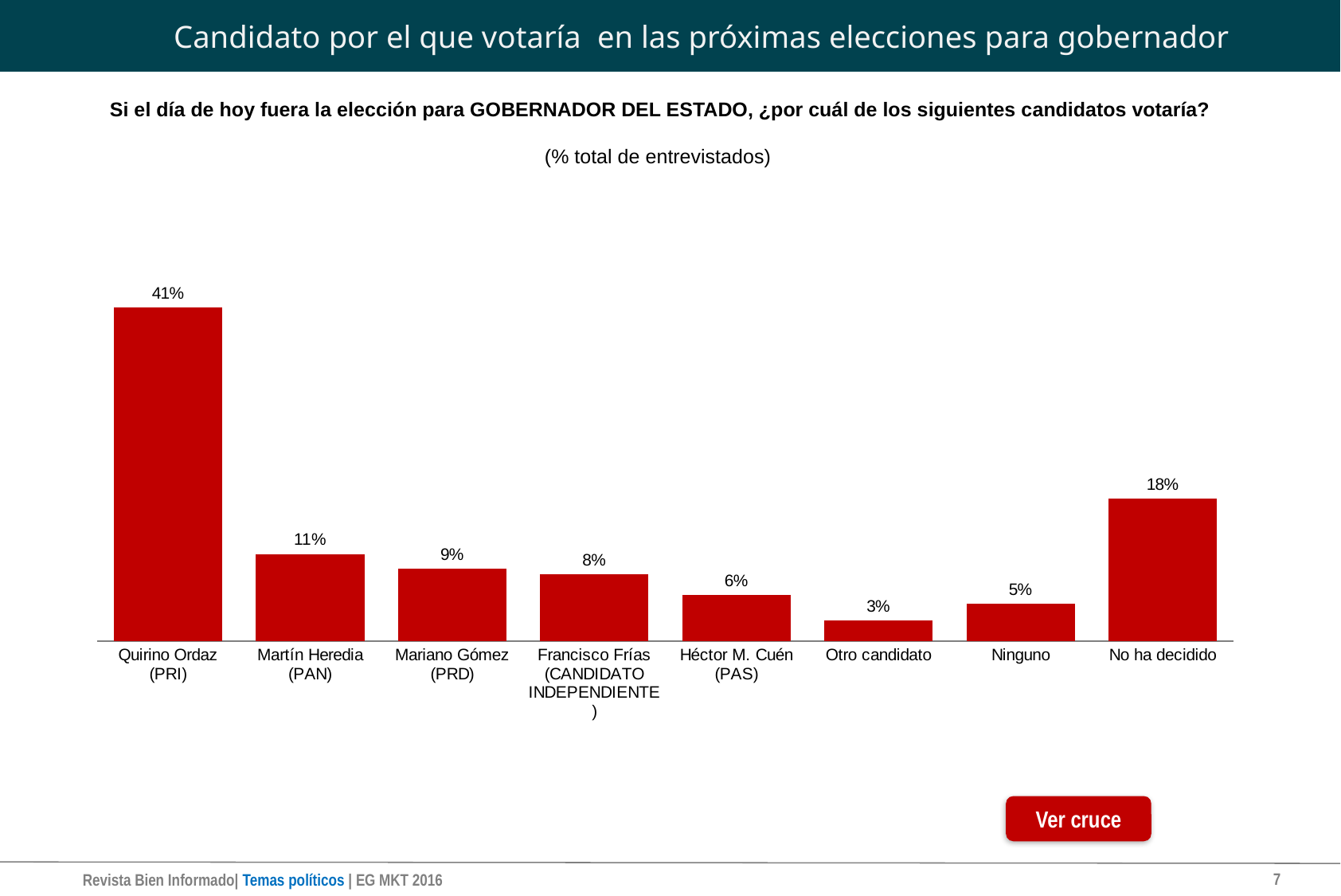
What percentage is shown for 'No ha decidido'? 18% What colour are the bars in the chart? Red What is the difference between the values for Quirino Ordaz (PRI) and Martín Heredia (PAN)? 30% What is the value for Héctor M. Cuén (PAS)? 6% Which category has the highest value in the chart? Quirino Ordaz (PRI) What percentage of respondents would vote for Quirino Ordaz (PRI)? 41% What is the value shown for Martín Heredia (PAN)? 11% What is the difference between the values for Mariano Gómez (PRD) and Francisco Frías (CANDIDATO INDEPENDIENTE)? 1% Which category has the lowest value in the chart? Otro candidato What type of chart is shown on the slide? Bar chart Which is larger, the value for 'Ninguno' or the value for 'Otro candidato'? Ninguno How many categories are shown on the x axis of the chart? 8